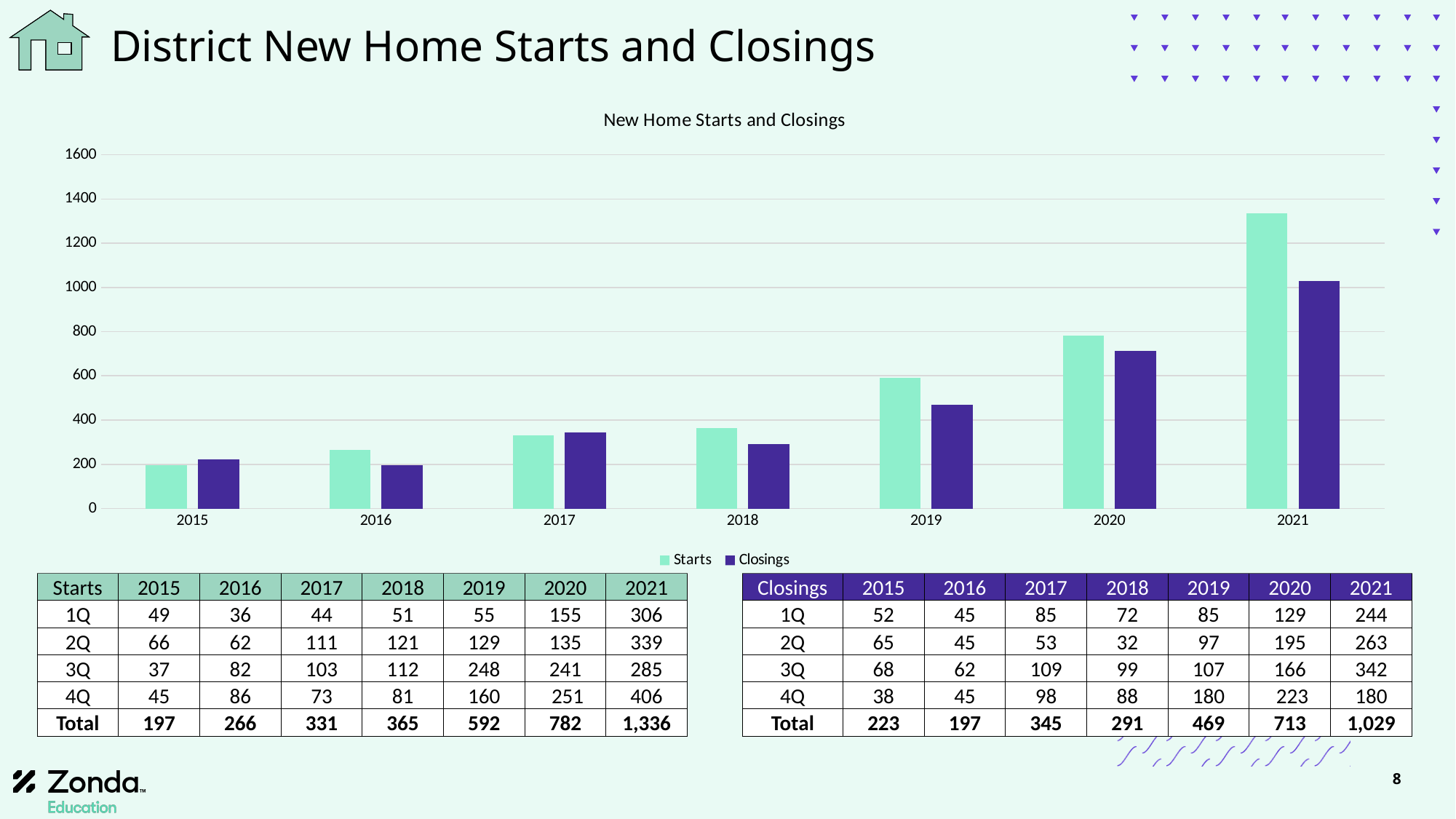
Which series is shown in dark purple in the chart legend? Closings Is the value for Closings in 2020 greater or less than 800? less In which year is the Starts bar the lowest? 2015 In 2018, which is larger, Starts or Closings? Starts What is the total Starts value for 2021 as printed on the slide? 1,336 How many series does the chart legend list? 2 In 2015, which is larger, Starts or Closings? Closings Is the value for Starts in 2021 greater or less than 1200? greater What kind of chart is shown on the slide? bar chart In which year is the Starts bar the highest? 2021 Do the Starts values rise or fall from 2015 to 2021? rise How many years are shown along the x axis of the chart? 7